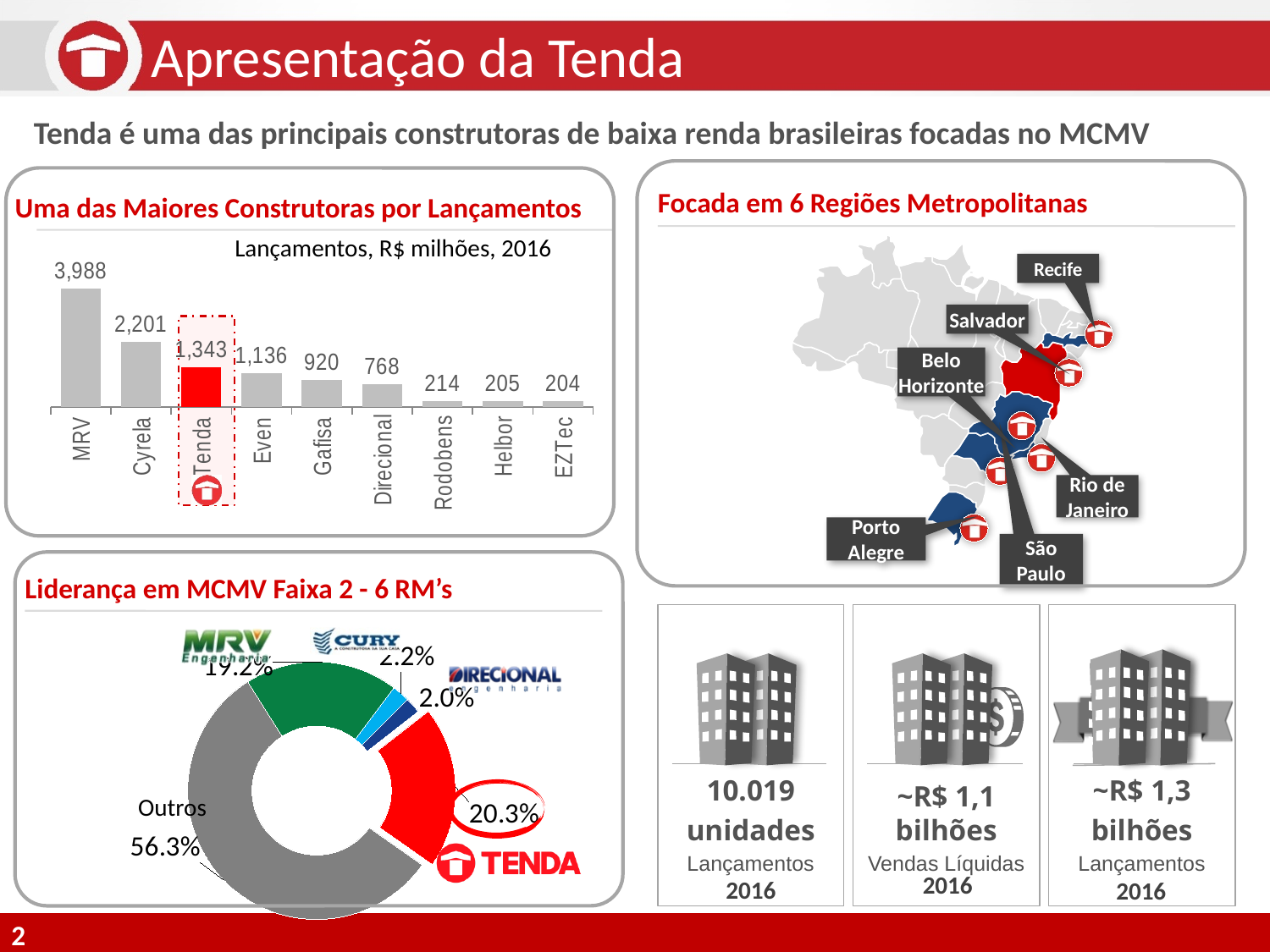
In the donut chart 'Liderança em MCMV Faixa 2 - 6 RM's', what is the difference between Tenda's share and MRV's share? 1.1% In the bar chart 'Uma das Maiores Construtoras por Lançamentos', what is the difference between MRV and Cyrela? 1,787 In the bar chart 'Uma das Maiores Construtoras por Lançamentos', do the values rise or fall from left to right? Fall What kind of chart is 'Uma das Maiores Construtoras por Lançamentos'? Bar chart In the bar chart 'Uma das Maiores Construtoras por Lançamentos', what is the value for Gafisa? 920 In the donut chart 'Liderança em MCMV Faixa 2 - 6 RM's', what share does Tenda have? 20.3% In the bar chart 'Uma das Maiores Construtoras por Lançamentos', which company has the lowest value? EZTec In the bar chart 'Uma das Maiores Construtoras por Lançamentos', which is larger, Even or Direcional? Even In the bar chart 'Uma das Maiores Construtoras por Lançamentos', which company has the highest value? MRV How many companies are shown in the bar chart 'Uma das Maiores Construtoras por Lançamentos'? 9 In the bar chart 'Uma das Maiores Construtoras por Lançamentos', what is the value for Tenda? 1,343 In the donut chart 'Liderança em MCMV Faixa 2 - 6 RM's', what is the share for Outros? 56.3%